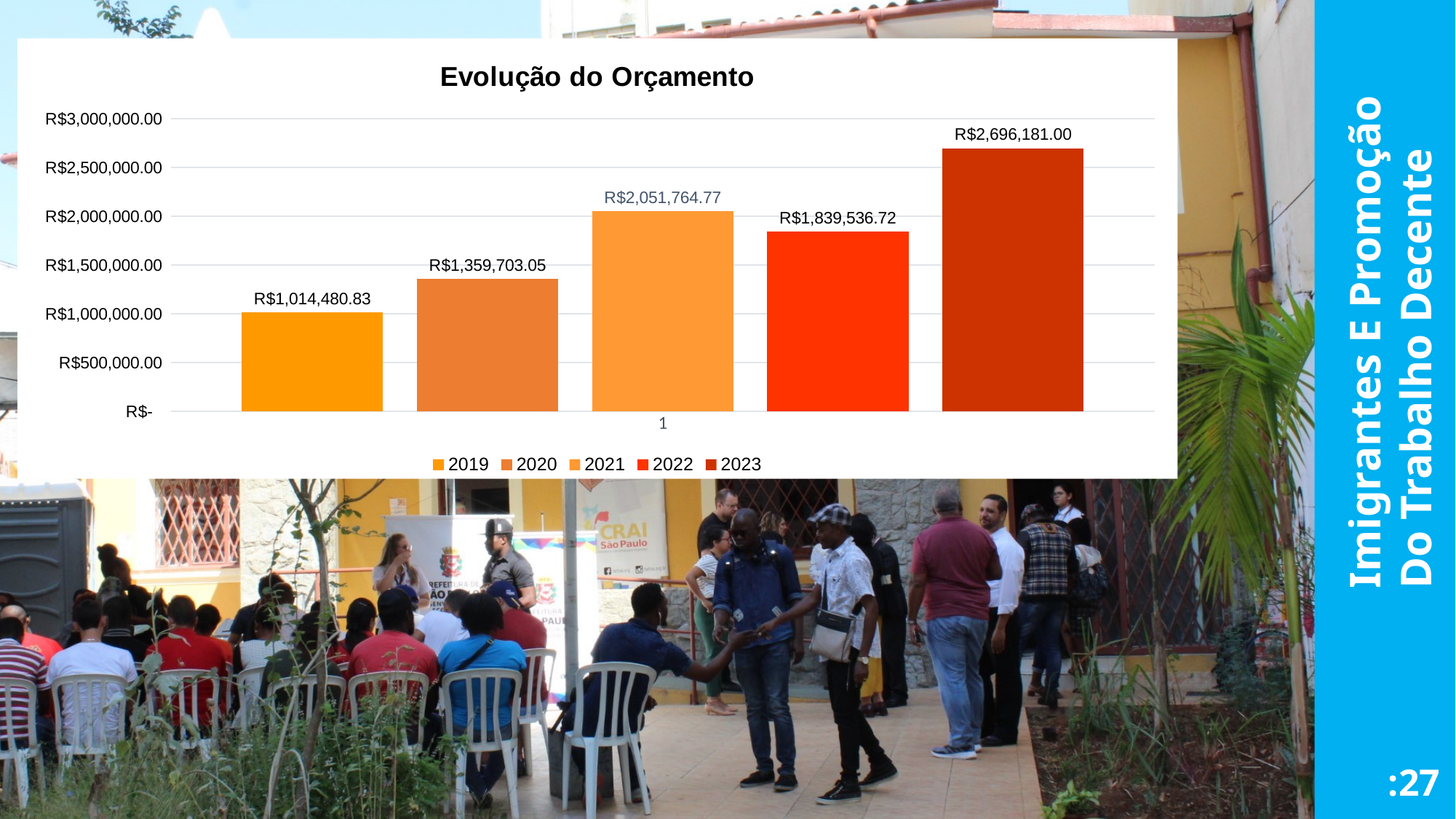
What is the value for 2023 in the 'Evolução do Orçamento' chart? R$2,696,181.00 How many series does the legend of the 'Evolução do Orçamento' chart list? 5 What is the value for 2022 in the 'Evolução do Orçamento' chart? R$1,839,536.72 Which year has the lowest value in the 'Evolução do Orçamento' chart? 2019 What is the value for 2019 in the 'Evolução do Orçamento' chart? R$1,014,480.83 What is the difference between the 2023 and 2022 values in the 'Evolução do Orçamento' chart? R$856,644.28 What is the value for 2021 in the 'Evolução do Orçamento' chart? R$2,051,764.77 Which year has the highest value in the 'Evolução do Orçamento' chart? 2023 What kind of chart is 'Evolução do Orçamento'? Bar chart What is the difference between the 2020 and 2019 values in the 'Evolução do Orçamento' chart? R$345,222.22 Which is larger in the 'Evolução do Orçamento' chart, the value for 2021 or the value for 2022? 2021 What is the title of the chart on the slide? Evolução do Orçamento